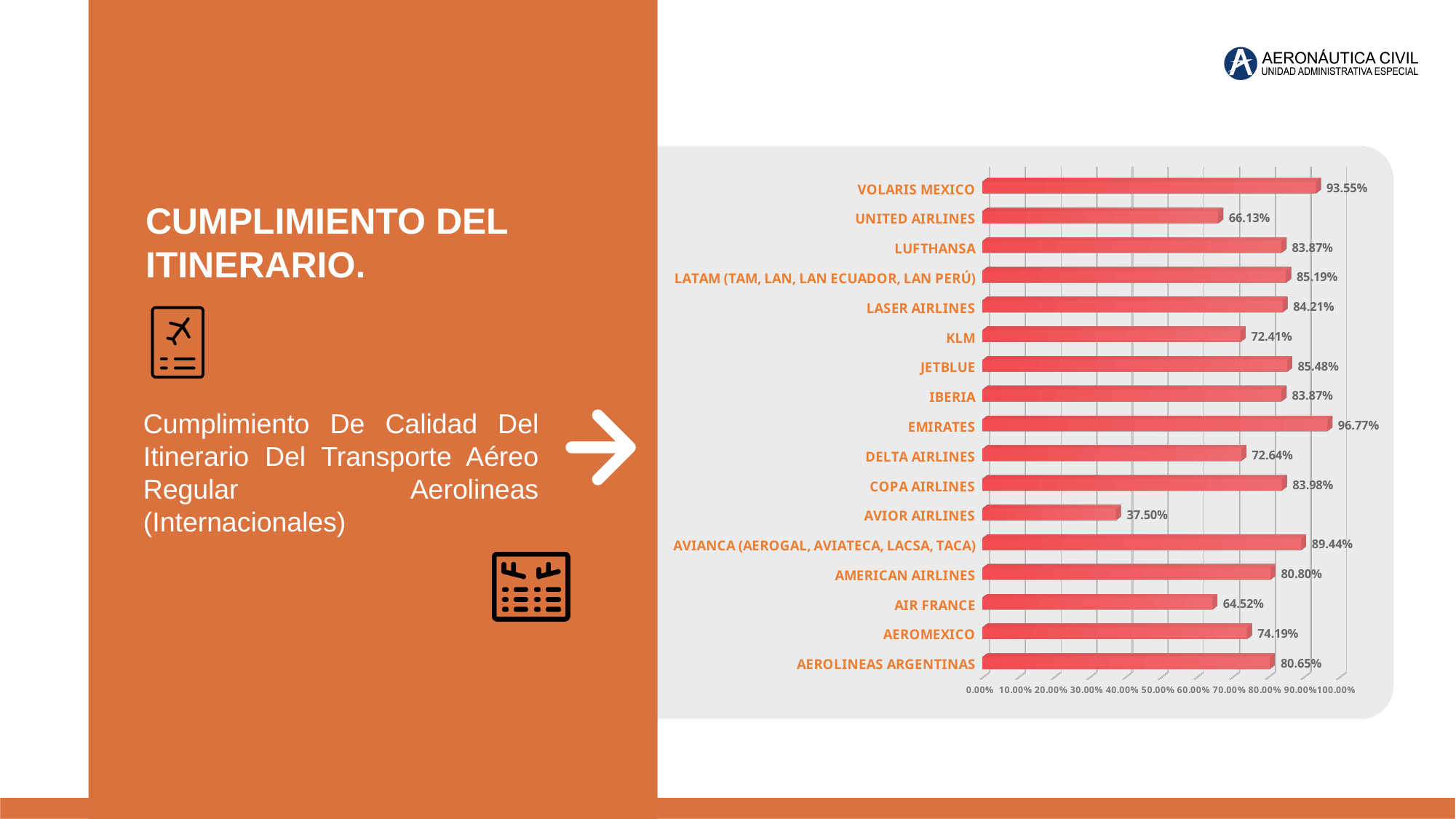
What is the value for AEROLINEAS ARGENTINAS? 80.65% What is the value for AVIOR AIRLINES? 37.50% Which airline has the highest value? EMIRATES How many airlines are shown in the chart? 17 What is the value for EMIRATES? 96.77% What is the difference between the values for VOLARIS MEXICO and UNITED AIRLINES? 27.42% Is the value for AIR FRANCE greater or less than 70.00%? less What is the difference between the values for EMIRATES and AVIOR AIRLINES? 59.27% Which airline has the lowest value? AVIOR AIRLINES Which is larger, the value for JETBLUE or the value for AIR FRANCE? JETBLUE What is the value for KLM? 72.41% What kind of chart is shown on the slide? bar chart